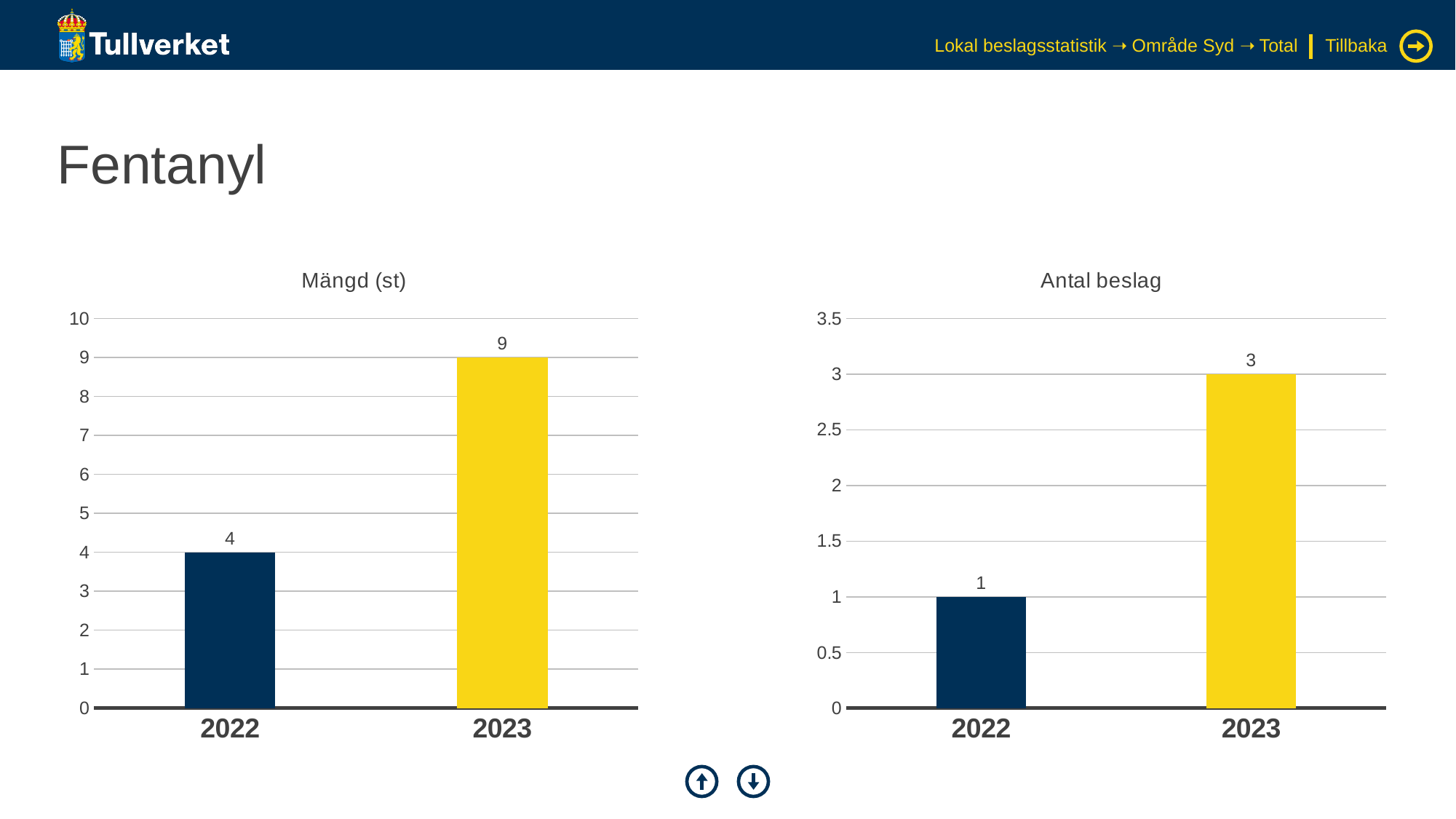
In the 'Mängd (st)' chart, what is the difference between the values for 2023 and 2022? 5 In the 'Antal beslag' chart, what is the difference between the values for 2023 and 2022? 2 In the 'Antal beslag' chart, what is the value for 2022? 1 In the 'Antal beslag' chart, which year has the lowest value? 2022 In the 'Antal beslag' chart, which year has the larger value, 2022 or 2023? 2023 How many categories are shown on the x axis of the 'Mängd (st)' chart? 2 In the 'Mängd (st)' chart, do the values rise or fall from 2022 to 2023? rise In the 'Mängd (st)' chart, what is the value for 2023? 9 In the 'Mängd (st)' chart, what is the value for 2022? 4 In the 'Mängd (st)' chart, which year has the highest value? 2023 What kind of chart is the 'Antal beslag' chart? bar chart In the 'Antal beslag' chart, what is the value for 2023? 3